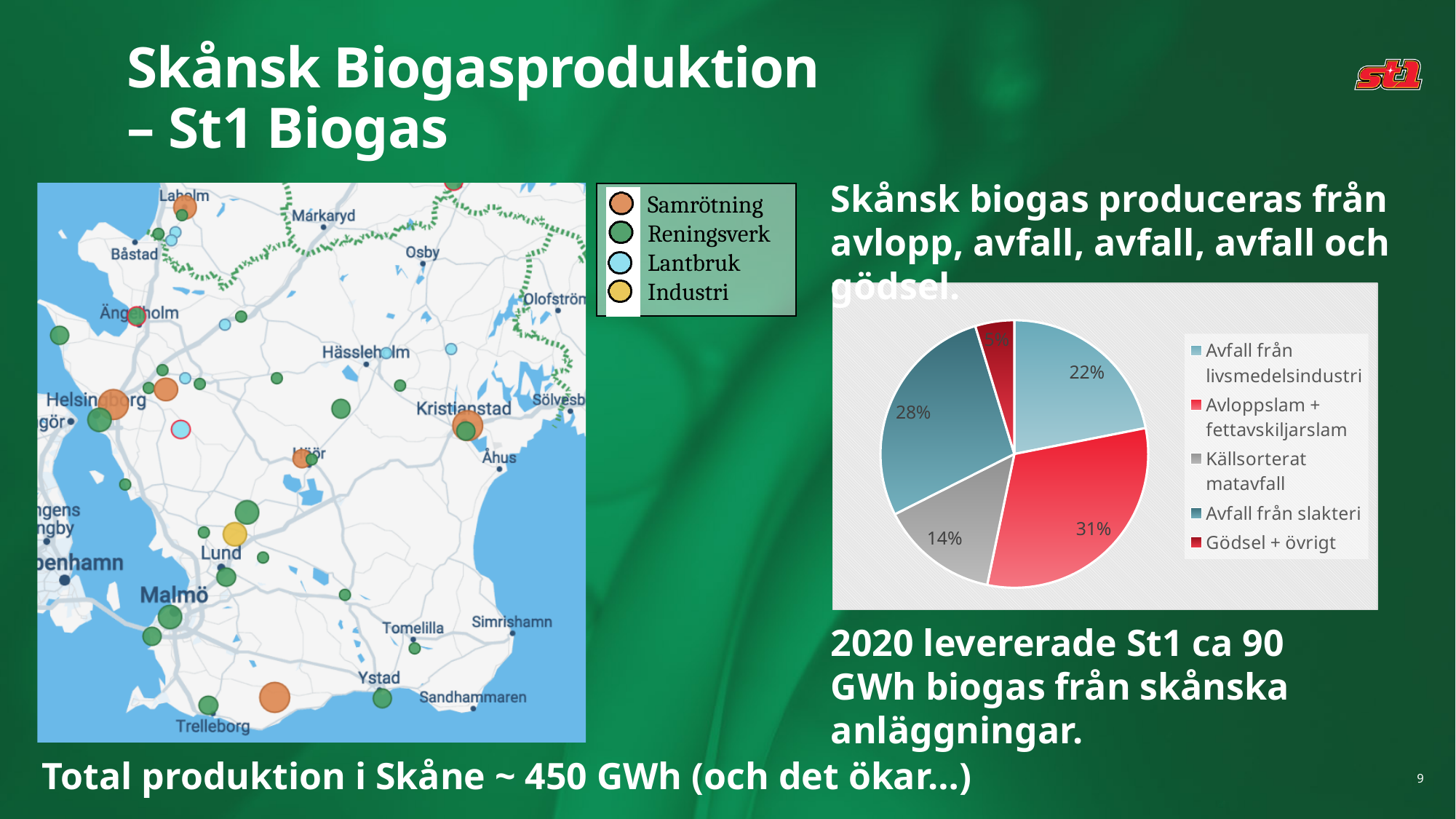
In the pie chart, what share is labelled for Avfall från livsmedelsindustri? 22% Which category has the smallest slice in the pie chart? Gödsel + övrigt In the pie chart, what share is labelled for Avfall från slakteri? 28% In the pie chart, what is the difference in percentage points between Avloppslam + fettavskiljarslam and Källsorterat matavfall? 17 In the pie chart, which is larger: Avfall från slakteri or Avfall från livsmedelsindustri? Avfall från slakteri What kind of chart is shown on the right side of the slide? pie chart In the pie chart, what share is labelled for Gödsel + övrigt? 5% Which category has the largest slice in the pie chart? Avloppslam + fettavskiljarslam What colour is the Gödsel + övrigt slice in the pie chart? dark red In the pie chart, what share is labelled for Avloppslam + fettavskiljarslam? 31% In the pie chart, what share is labelled for Källsorterat matavfall? 14% How many categories does the pie chart's legend list? 5